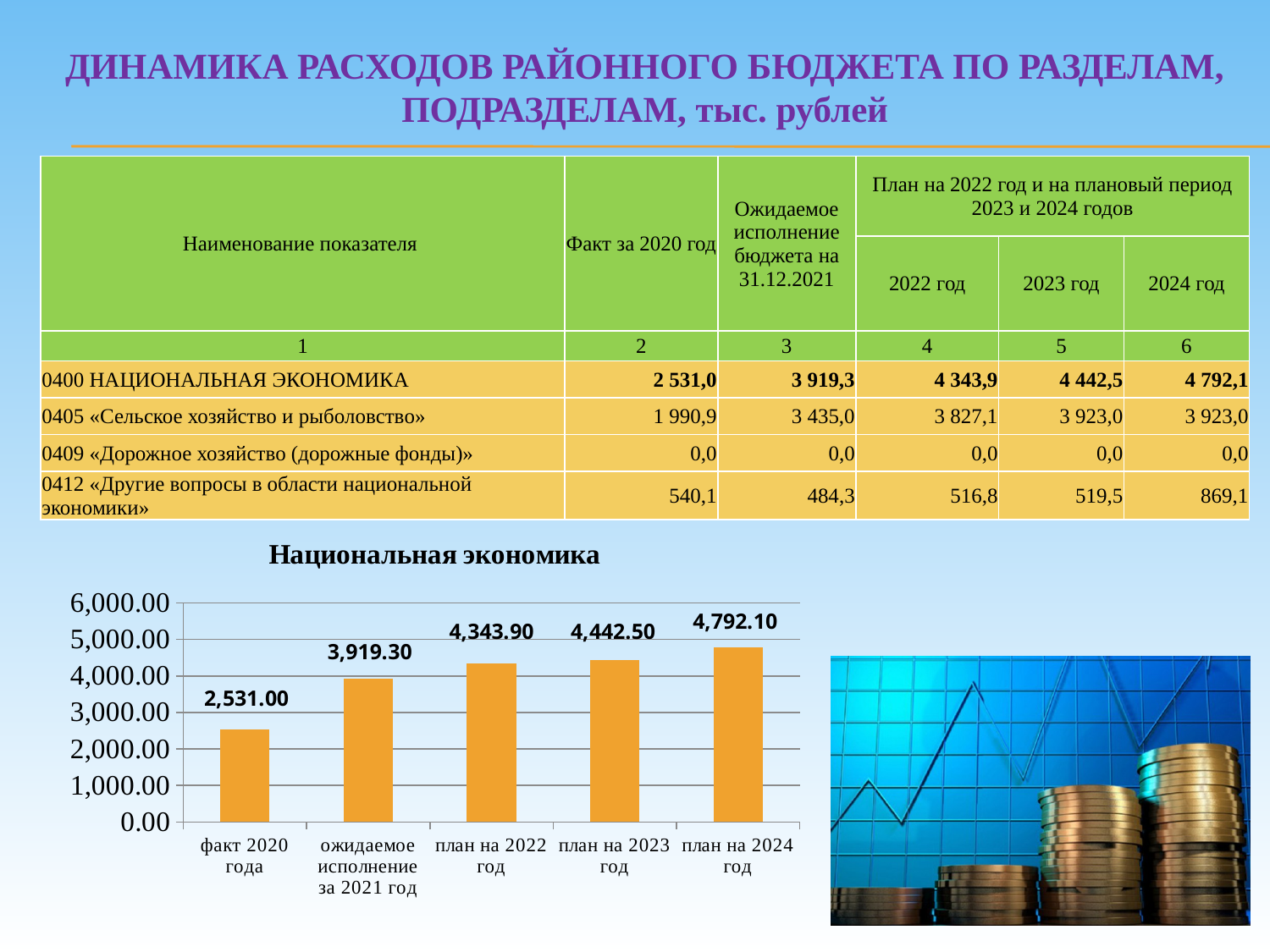
What is the difference between the values for "ожидаемое исполнение за 2021 год" and "факт 2020 года" in the "Национальная экономика" chart? 1,388.30 What is the value for "факт 2020 года" in the "Национальная экономика" chart? 2,531.00 Is the value for "план на 2023 год" in the "Национальная экономика" chart greater or less than 4,000.00? greater What is the difference between the values for "план на 2024 год" and "план на 2023 год" in the "Национальная экономика" chart? 349.60 Which is larger in the "Национальная экономика" chart: the value for "план на 2022 год" or "факт 2020 года"? план на 2022 год Do the values in the "Национальная экономика" chart rise or fall from left to right along the x axis? rise What is the value for "ожидаемое исполнение за 2021 год" in the "Национальная экономика" chart? 3,919.30 How many bars are shown in the "Национальная экономика" chart? 5 What is the value for "план на 2024 год" in the "Национальная экономика" chart? 4,792.10 Which category has the highest value in the "Национальная экономика" chart? план на 2024 год Which category has the lowest value in the "Национальная экономика" chart? факт 2020 года What type of chart is shown under the title "Национальная экономика"? bar chart